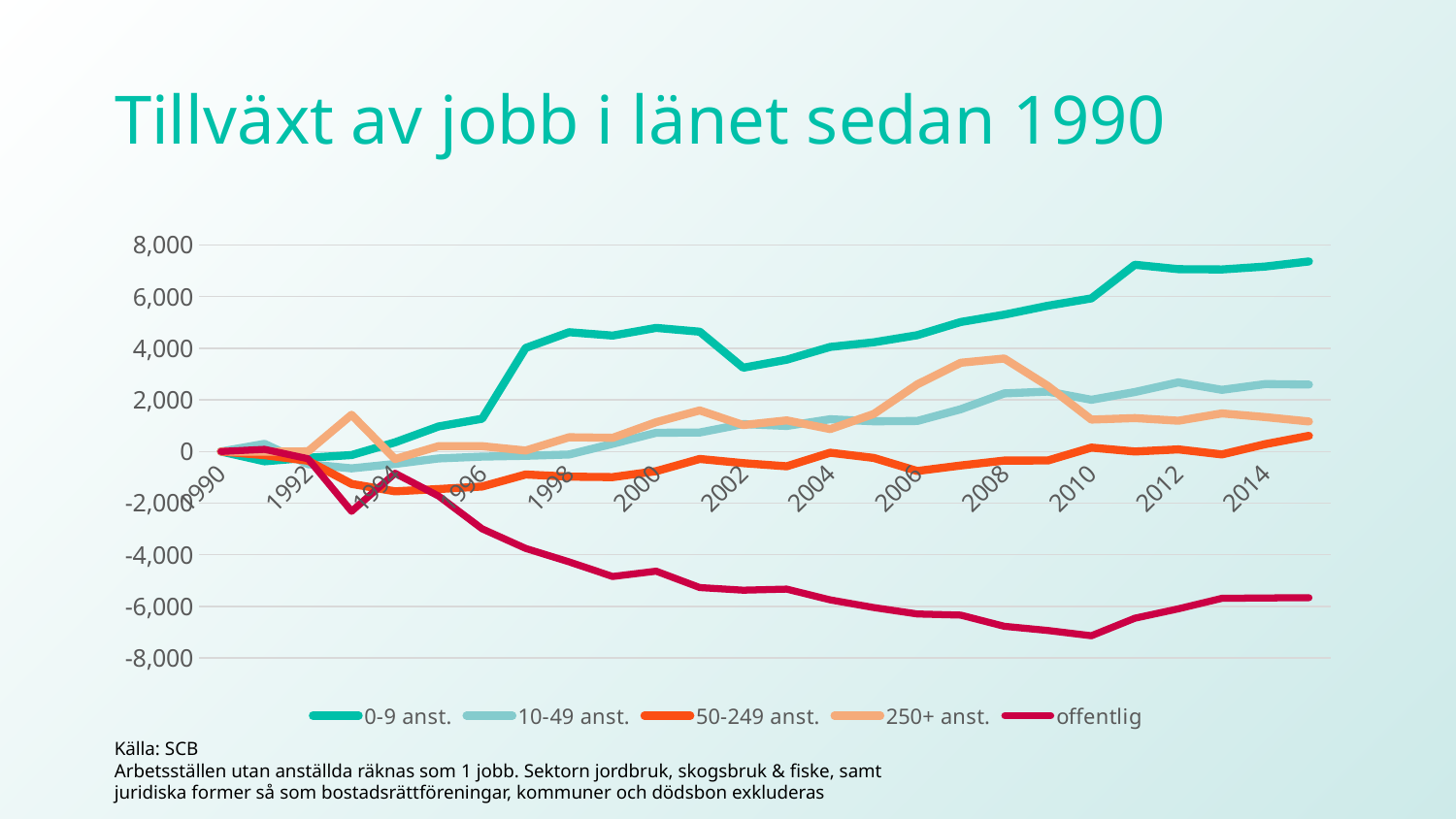
What kind of chart is shown on the slide? line chart Which series has the highest value at the right end of the chart (2014)? 0-9 anst. Which series is drawn in the dark red line? offentlig In 2008, which series has the higher value, 250+ anst. or 10-49 anst.? 250+ anst. Does the 0-9 anst. series generally rise or fall from 1990 to 2014? rise What is the title of the chart? Tillväxt av jobb i länet sedan 1990 Which series has the lowest value at the right end of the chart (2014)? offentlig Is the value for 0-9 anst. in 2014 greater or less than 6,000? greater Does the offentlig series generally rise or fall from 1990 to 2010? fall Is the value for 10-49 anst. in 2012 greater or less than 2,000? greater Is the value for offentlig in 2010 greater or less than -6,000? less How many series does the legend list? 5